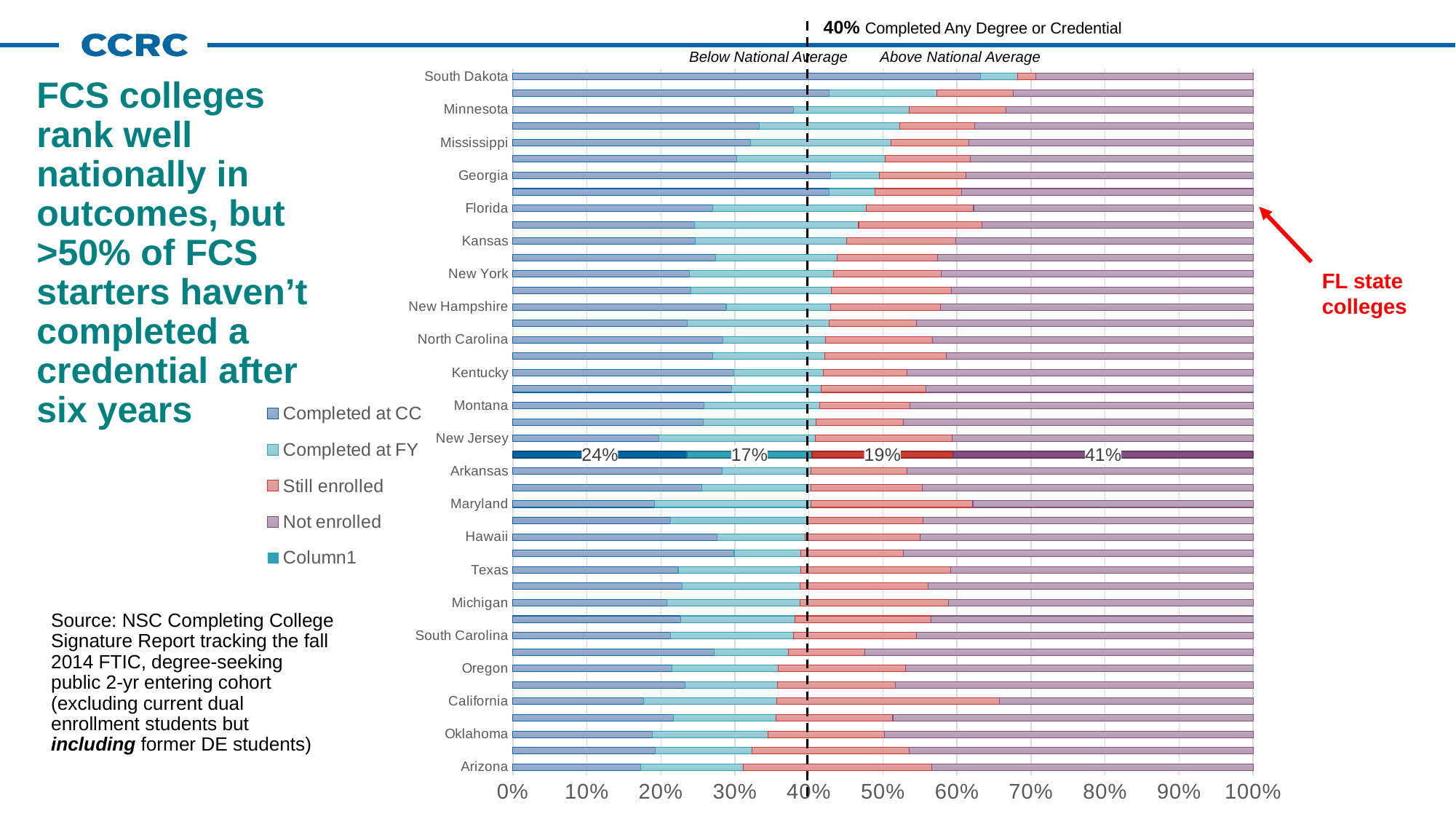
Is the Completed at CC value for South Dakota greater or less than 50%? greater How many series does the legend list? 5 What national average value does the dashed vertical line mark? 40% What kind of chart is shown on the slide? Stacked bar chart